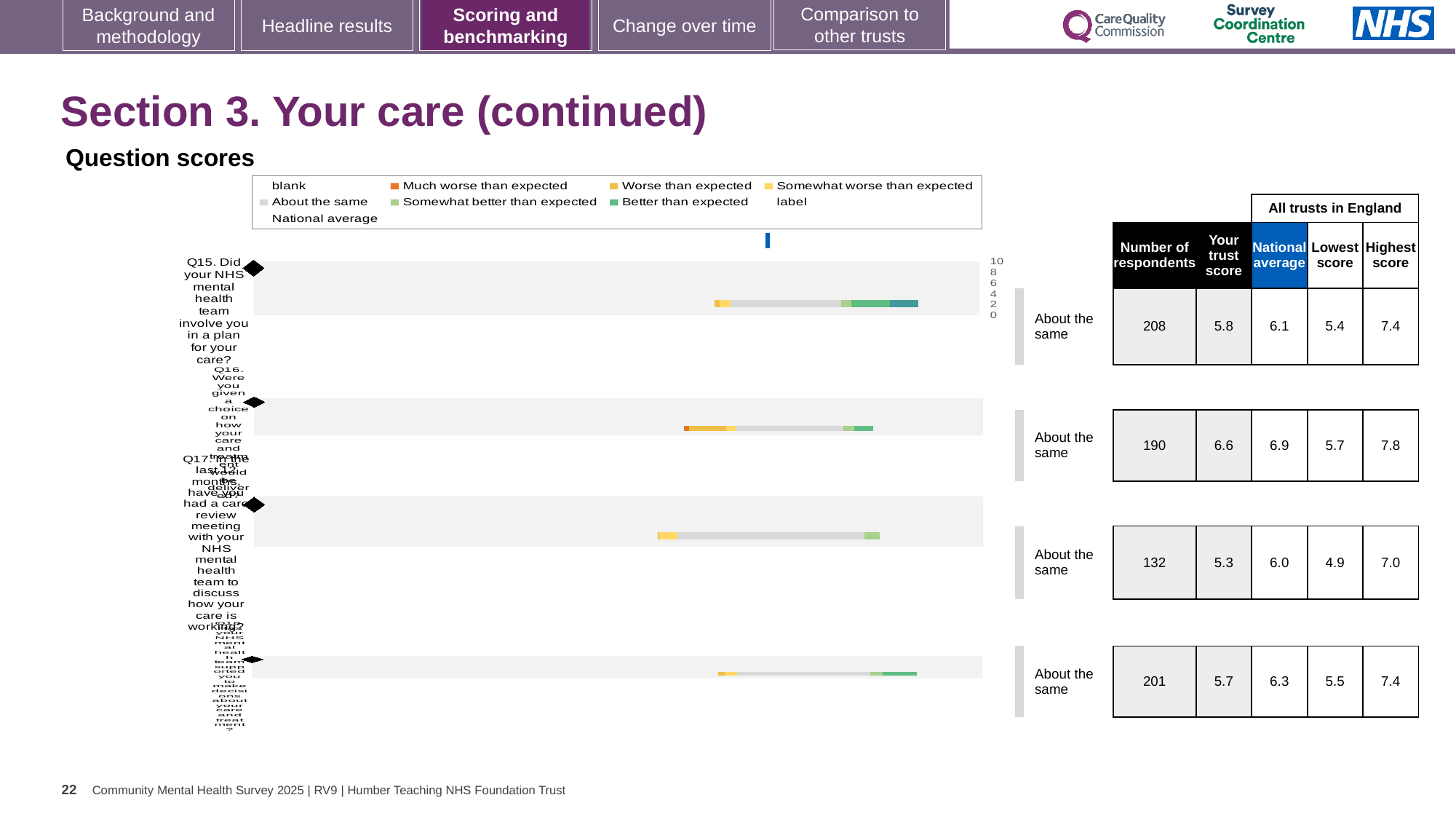
For Q16, which is larger: the trust score or the national average? National average What benchmark category is shown next to the Q15 bar? About the same What is the trust score for Q16 (choice on how your care and treatment would be delivered)? 6.6 What kind of chart is shown under "Question scores"? bar chart What is the highest score among all trusts in England for Q18? 7.4 Which question has the most respondents? Q15 What is the difference between the national average and the trust score for Q15? 0.3 What is the national average for Q17 (care review meeting in the last 12 months)? 6.0 What is the number of respondents for Q15 in the Question scores table? 208 How many questions (bars) are plotted in the Question scores chart? 4 Which question has the lowest trust score? Q17 What is the difference between the highest and lowest scores for Q17? 2.1